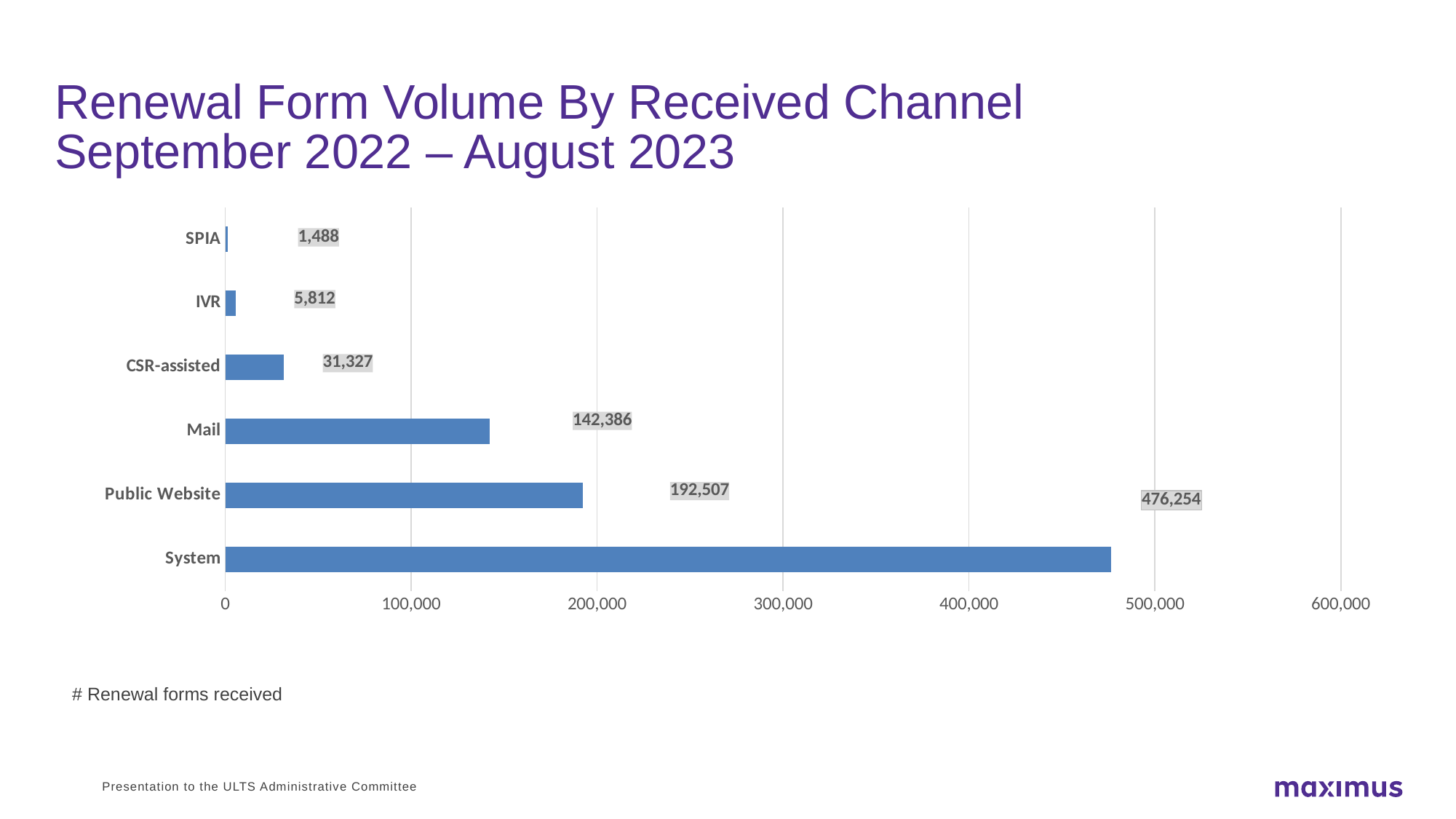
What is the value for SPIA? 1,488 What is the difference between the values for IVR and SPIA? 4,324 Which is larger, the value for Public Website or the value for Mail? Public Website Which channel has the highest renewal form volume? System What is the value for Mail? 142,386 What is the difference between the values for System and Public Website? 283,747 What is the value for CSR-assisted? 31,327 What is the value for System? 476,254 What kind of chart is shown on the slide? Bar chart Is the value for Mail greater or less than 100,000? greater Which channel has the lowest renewal form volume? SPIA How many channels are shown in the chart? 6